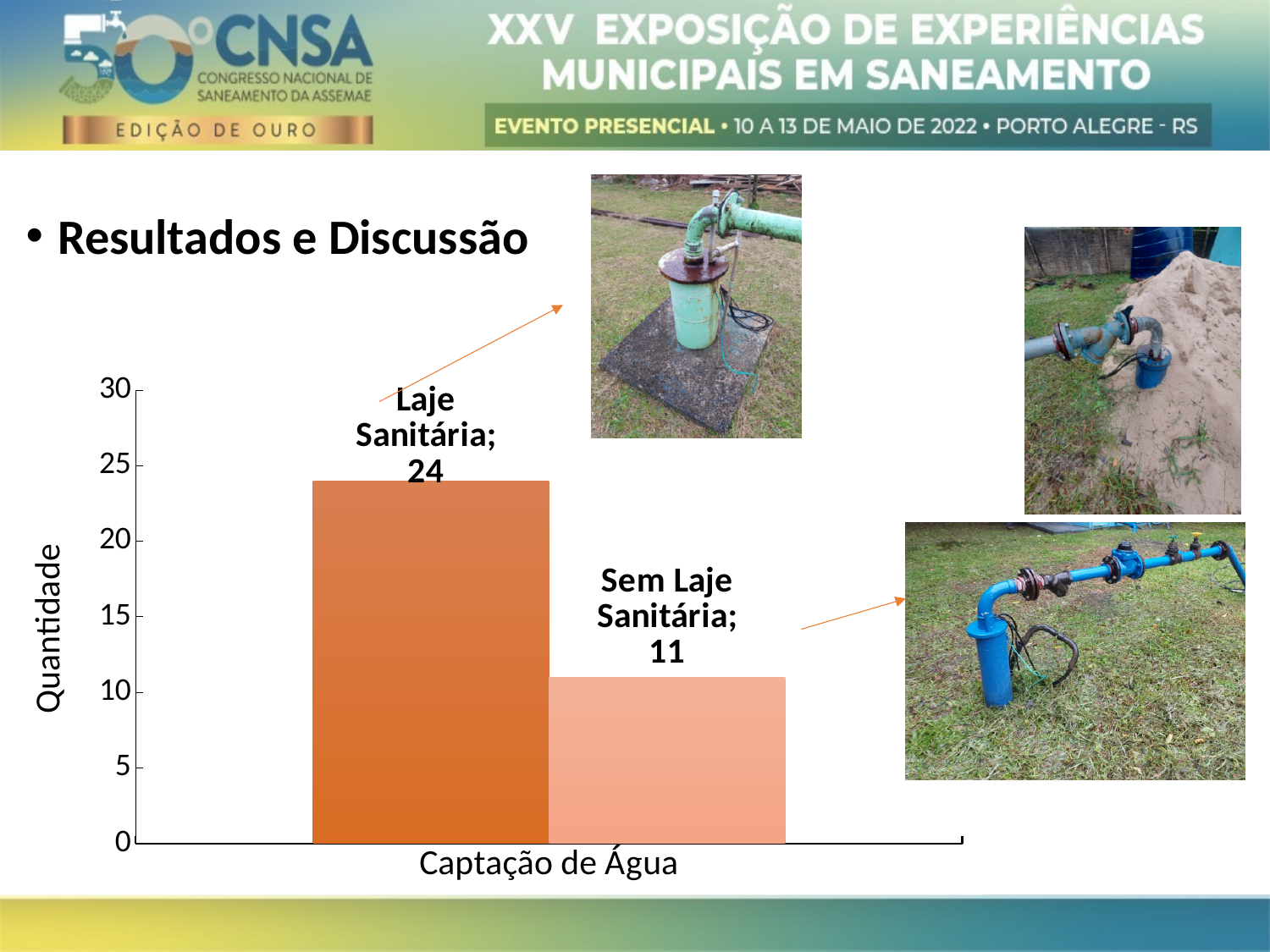
How many bars are plotted in the chart? 2 What is the total of the two bar values? 35 What is the value for Laje Sanitária? 24 What is the value for Sem Laje Sanitária? 11 Which is larger, the value for Laje Sanitária or the value for Sem Laje Sanitária? Laje Sanitária Which category has the highest value? Laje Sanitária Is the value for Laje Sanitária greater or less than 20? greater Is the value for Sem Laje Sanitária greater or less than 15? less What is the difference between the values for Laje Sanitária and Sem Laje Sanitária? 13 Which category has the lowest value? Sem Laje Sanitária What is the label of the vertical axis? Quantidade What kind of chart is shown on the slide? bar chart